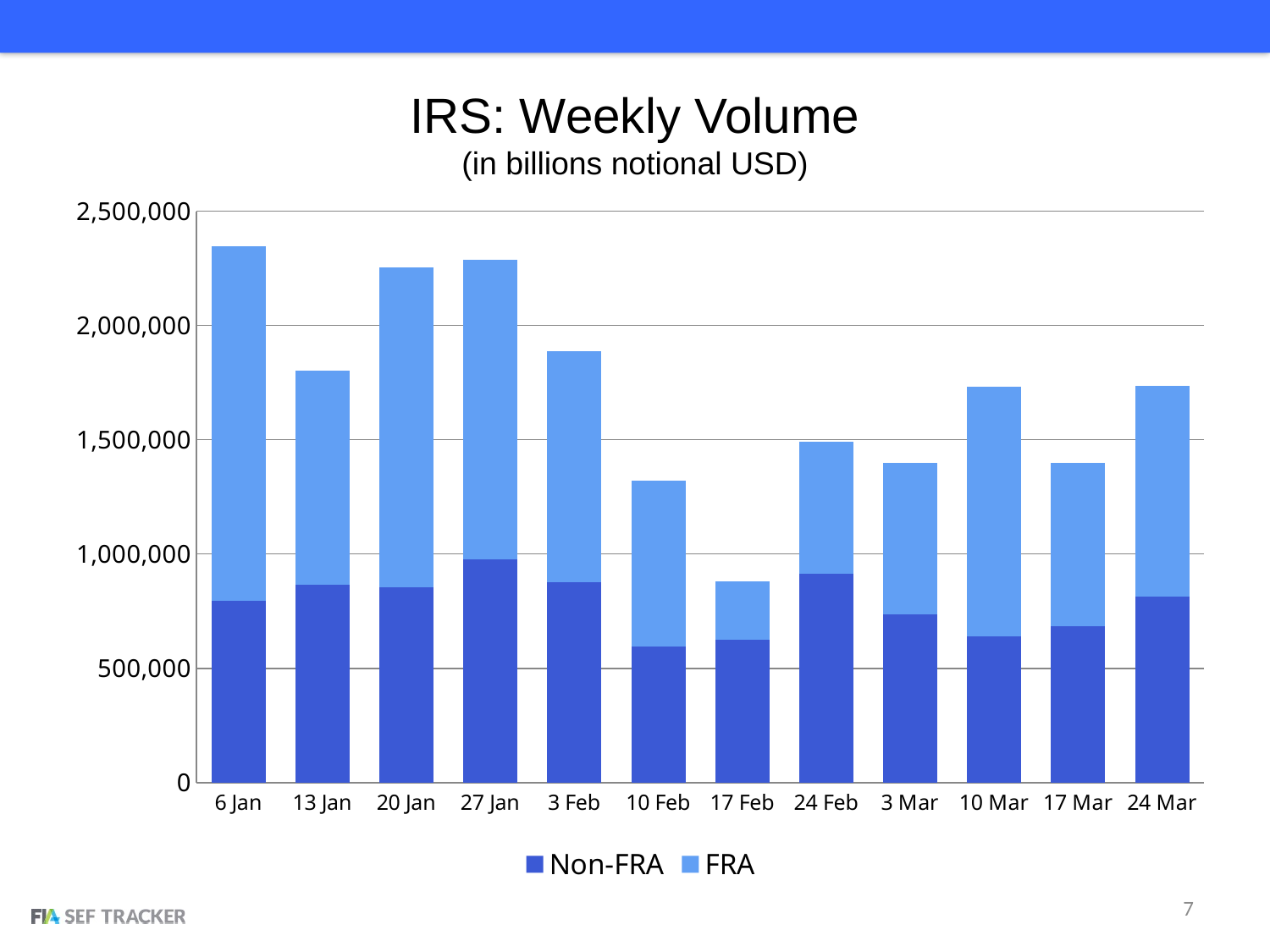
What are the two series named in the legend? Non-FRA and FRA What kind of chart is shown on the slide? Stacked bar chart Which week has the lowest total weekly volume? 17 Feb Which week has the larger total volume, 6 Jan or 13 Jan? 6 Jan How many series does the legend list? 2 Is the total volume for 17 Feb greater or less than 1,000,000? less Which week has the lowest Non-FRA volume? 10 Feb Which week has the highest total weekly volume? 6 Jan Is the total volume for 6 Jan greater or less than 2,000,000? greater Which week has the highest Non-FRA volume? 27 Jan Is the Non-FRA volume for 10 Feb greater or less than 500,000? greater How many weeks (categories) are shown on the x axis? 12